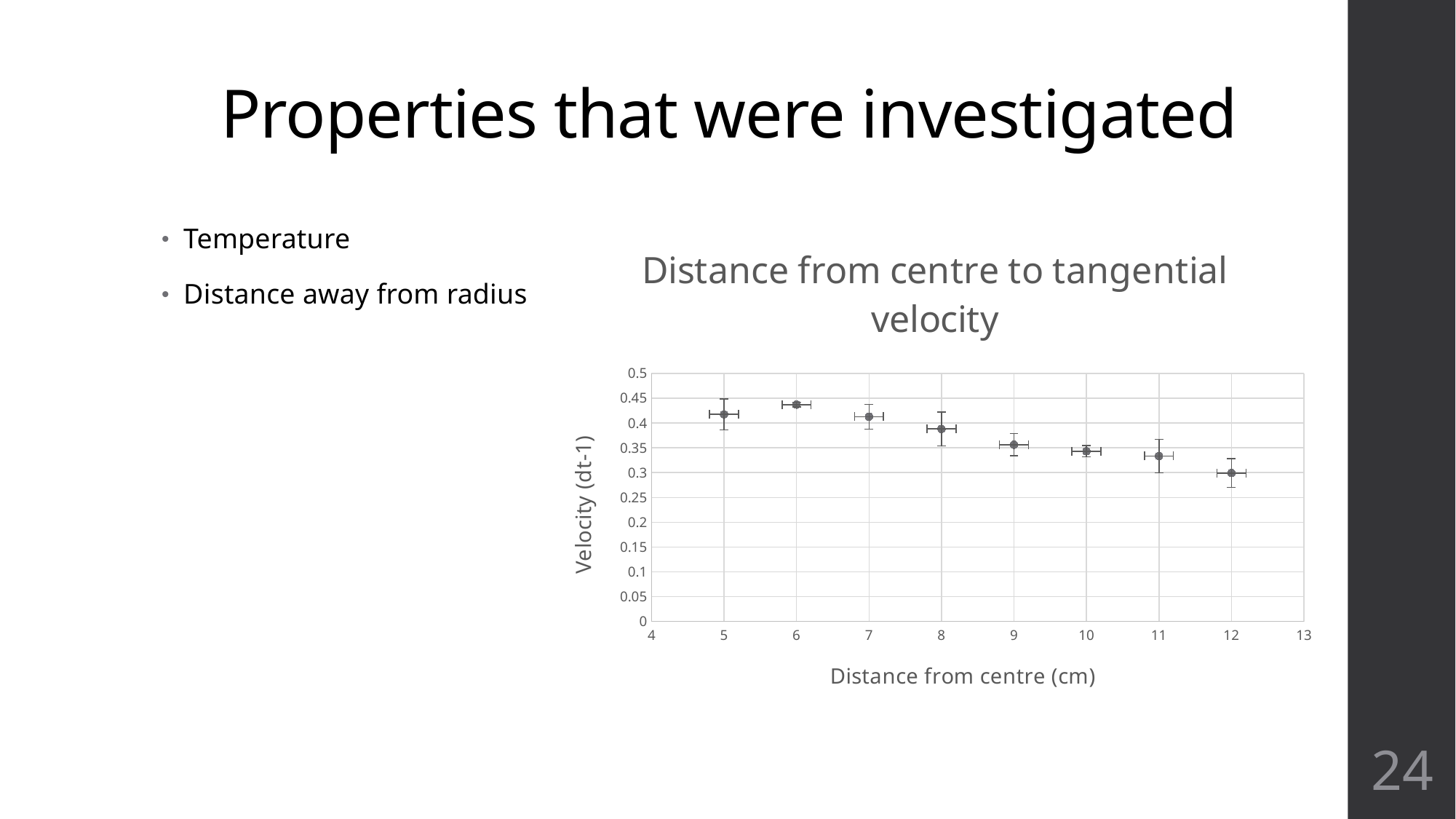
At which distance from centre is the velocity lowest? 12 Is the velocity at a distance of 10 cm greater or less than 0.4? less What kind of chart is shown on the slide? Scatter plot How many data points are plotted on the chart? 8 Is the velocity at a distance of 6 cm greater or less than 0.4? greater Is the velocity at a distance of 9 cm greater or less than 0.3? greater Which has the larger velocity: the point at 7 cm or the point at 11 cm? 7 cm At which distance from centre is the velocity highest? 6 Do the velocity values generally rise or fall as the distance from centre increases? Fall What is the label of the x axis of the chart? Distance from centre (cm) What is the title of the chart? Distance from centre to tangential velocity